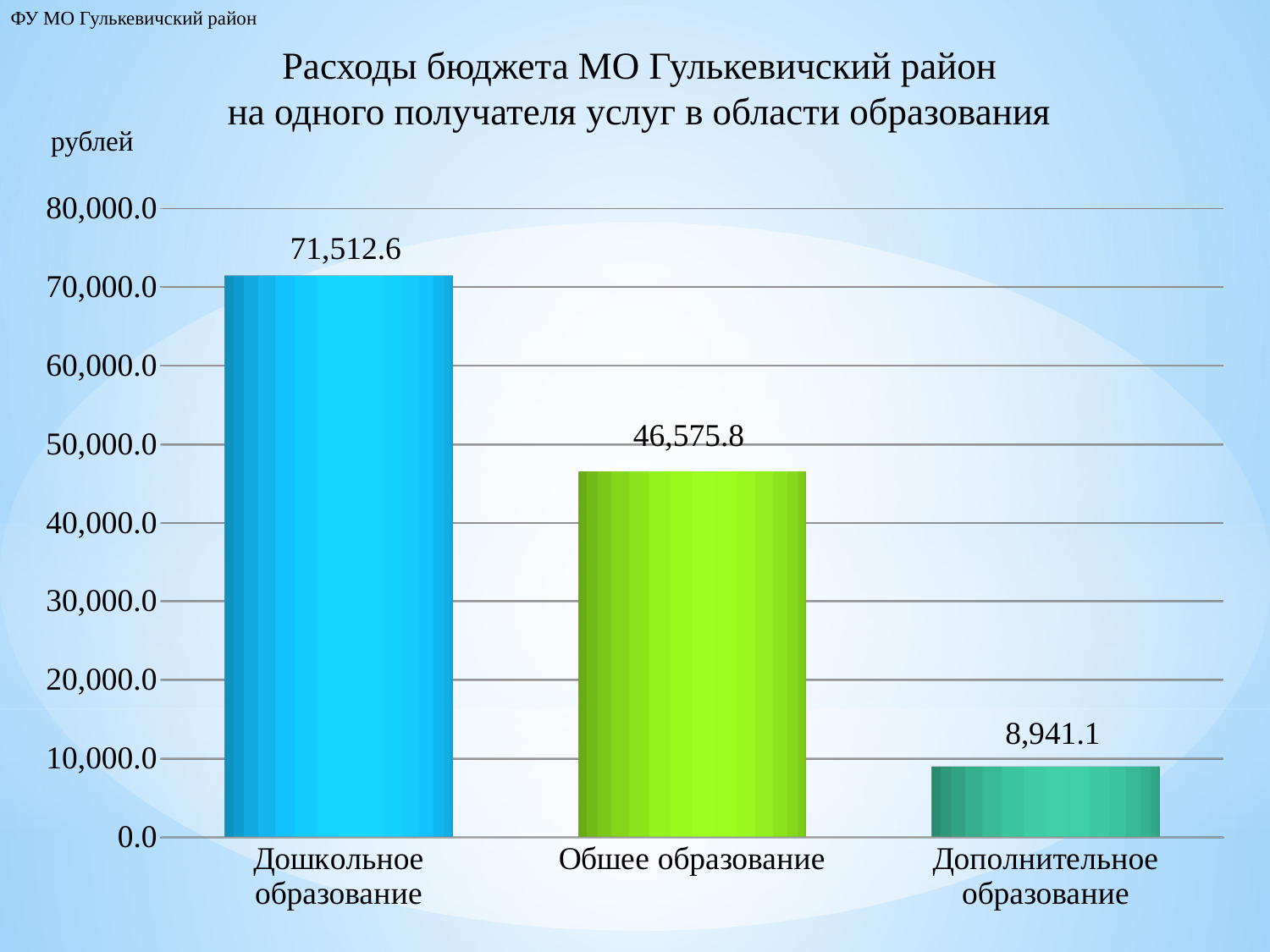
What is the difference between the values for Дошкольное образование and Общее образование? 24,936.8 Which category has the lowest value? Дополнительное образование How many categories are shown in the chart? 3 Which category has the highest value? Дошкольное образование What kind of chart is shown on the slide? bar chart What unit is shown on the vertical axis of the chart? рублей Which is larger, the value for Общее образование or the value for Дополнительное образование? Общее образование What is the value for Дополнительное образование? 8,941.1 Is the value for Общее образование greater or less than 50,000.0? less What is the value for Дошкольное образование? 71,512.6 What is the difference between the values for Общее образование and Дополнительное образование? 37,634.7 What is the value for Общее образование? 46,575.8